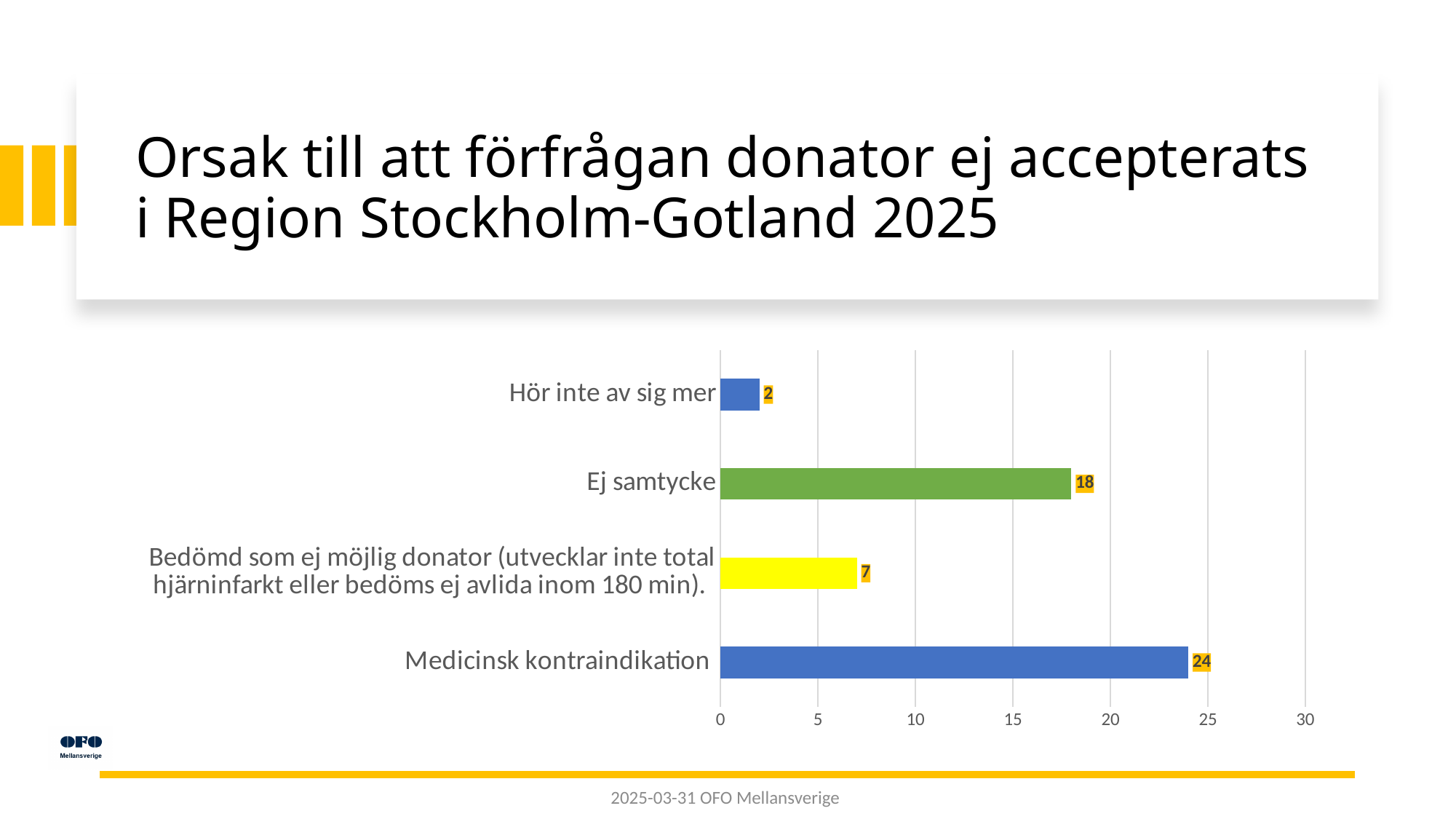
How many categories are shown in the chart? 4 What is the value for Hör inte av sig mer? 2 What is the difference between the values for Ej samtycke and Hör inte av sig mer? 16 Is the value for Medicinsk kontraindikation greater or less than 20? greater Which is larger, the value for Ej samtycke or the value for Bedömd som ej möjlig donator? Ej samtycke Which category has the lowest value? Hör inte av sig mer What is the value for the category 'Bedömd som ej möjlig donator (utvecklar inte total hjärninfarkt eller bedöms ej avlida inom 180 min).'? 7 Which category has the highest value? Medicinsk kontraindikation What kind of chart is shown on the slide? Bar chart What is the difference between the values for Medicinsk kontraindikation and Ej samtycke? 6 What is the value for Medicinsk kontraindikation? 24 What is the value for Ej samtycke? 18